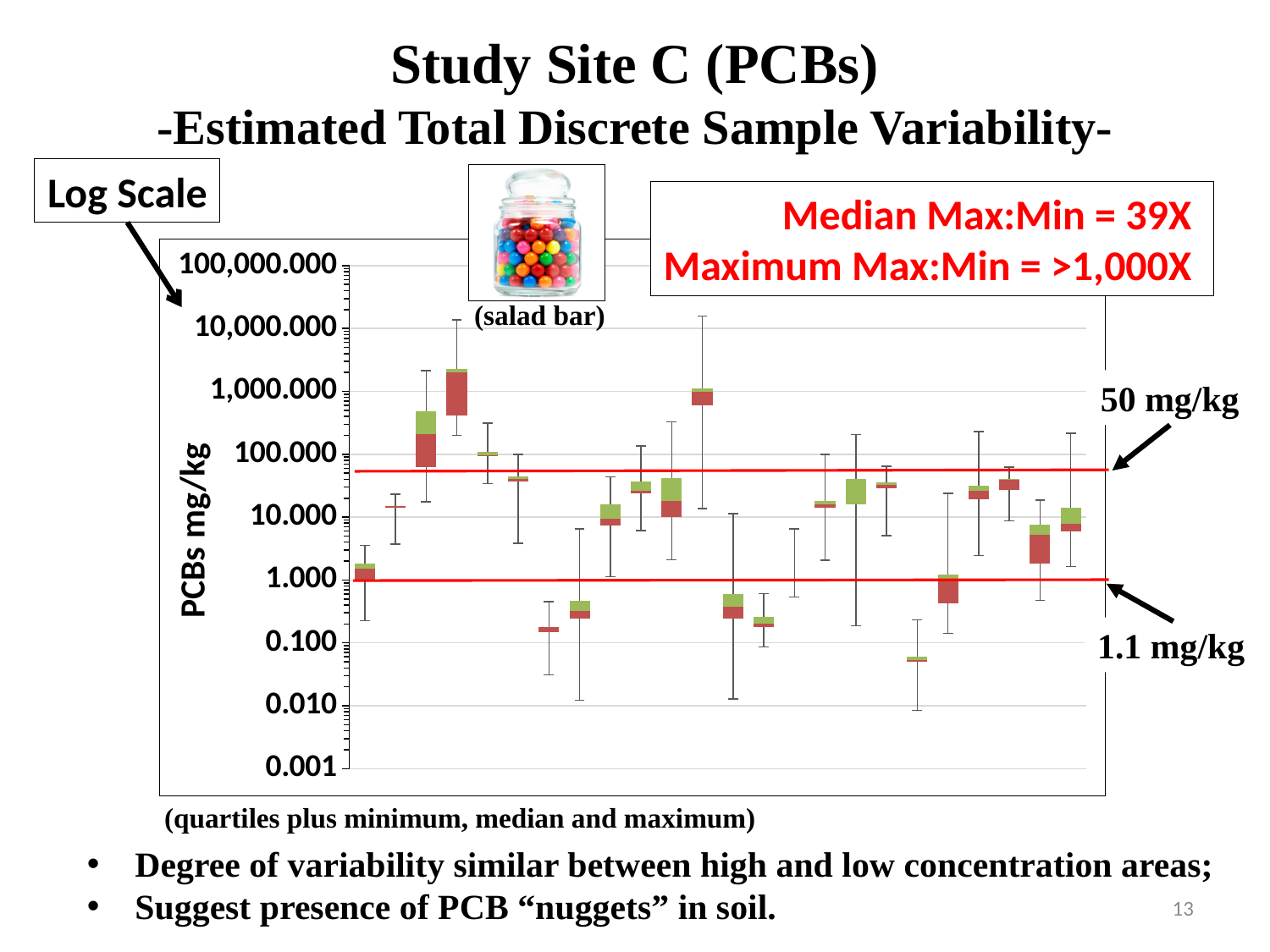
Is the median of the lowest box plot on the chart greater or less than 0.100? less Is the median of the tallest box plot (fourth from the left) greater or less than 100? greater What type of scale does the chart's vertical axis use, according to the callout? Log Scale What concentration does the upper red horizontal reference line represent? 50 mg/kg What is the Median Max:Min ratio stated on the slide? 39X What is the Maximum Max:Min ratio stated on the slide? >1,000X What kind of chart is shown on the slide? Box-and-whisker (box plot) chart What concentration does the lower red horizontal reference line represent? 1.1 mg/kg What is the title of the chart on the slide? Study Site C (PCBs) -Estimated Total Discrete Sample Variability- What is the label on the vertical axis of the chart? PCBs mg/kg What is the lowest tick value shown on the vertical axis? 0.001 What is the highest tick value shown on the vertical axis? 100,000.000